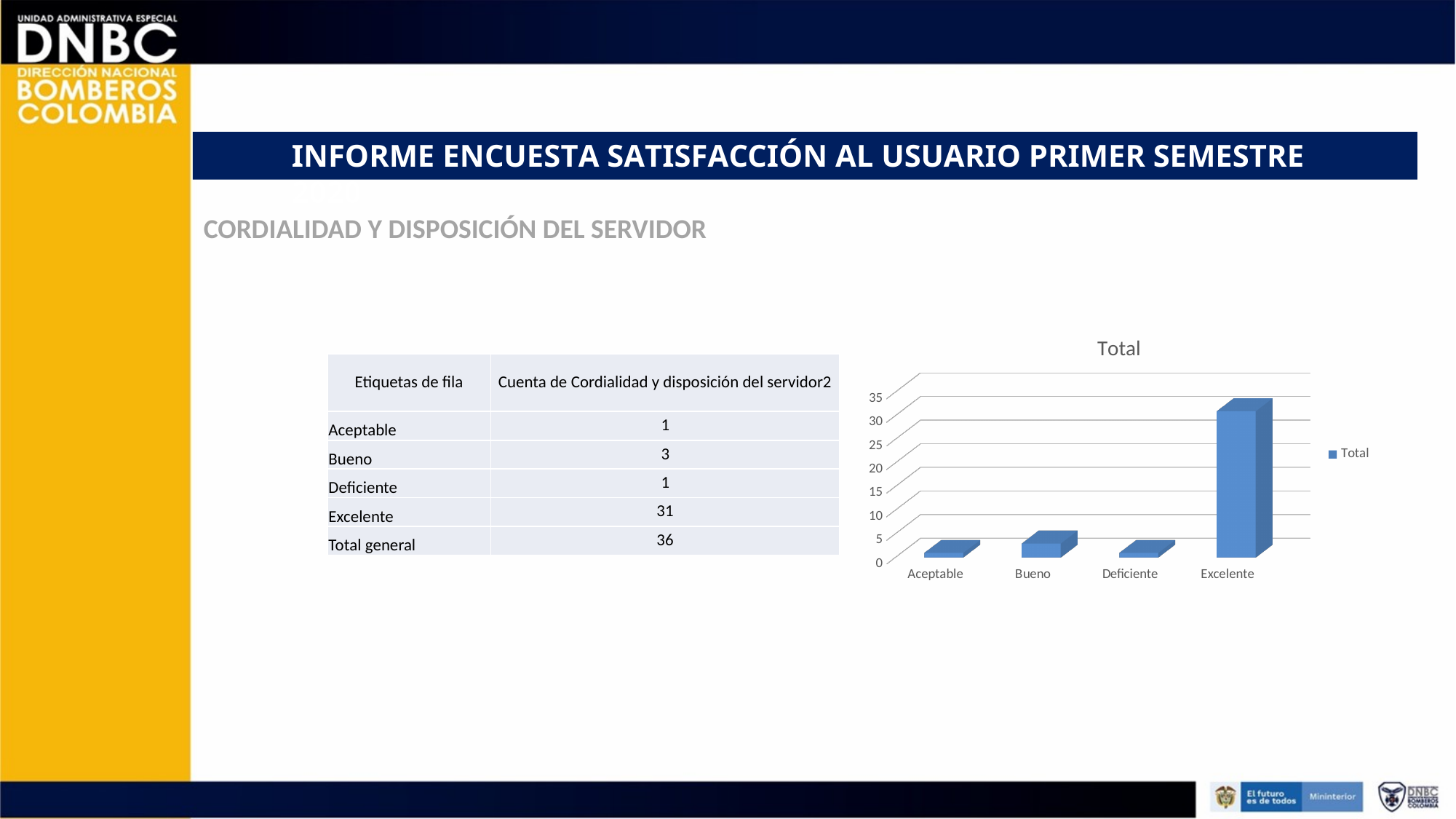
What type of chart is shown on the slide? bar chart What is the total general shown in the table on the slide? 36 According to the table on the slide, what is the count for Bueno? 3 Which is larger in the chart, the value for Bueno or the value for Aceptable? Bueno According to the table on the slide, what is the count for Excelente? 31 How many series does the chart legend list? 1 Is the value for Excelente greater or less than 25? greater Which category has the highest bar in the chart? Excelente Is the value for Bueno greater or less than 5? less Using the values in the table, what is the difference between the counts for Excelente and Bueno? 28 What is the title of the chart? Total How many categories are shown on the x axis of the chart? 4